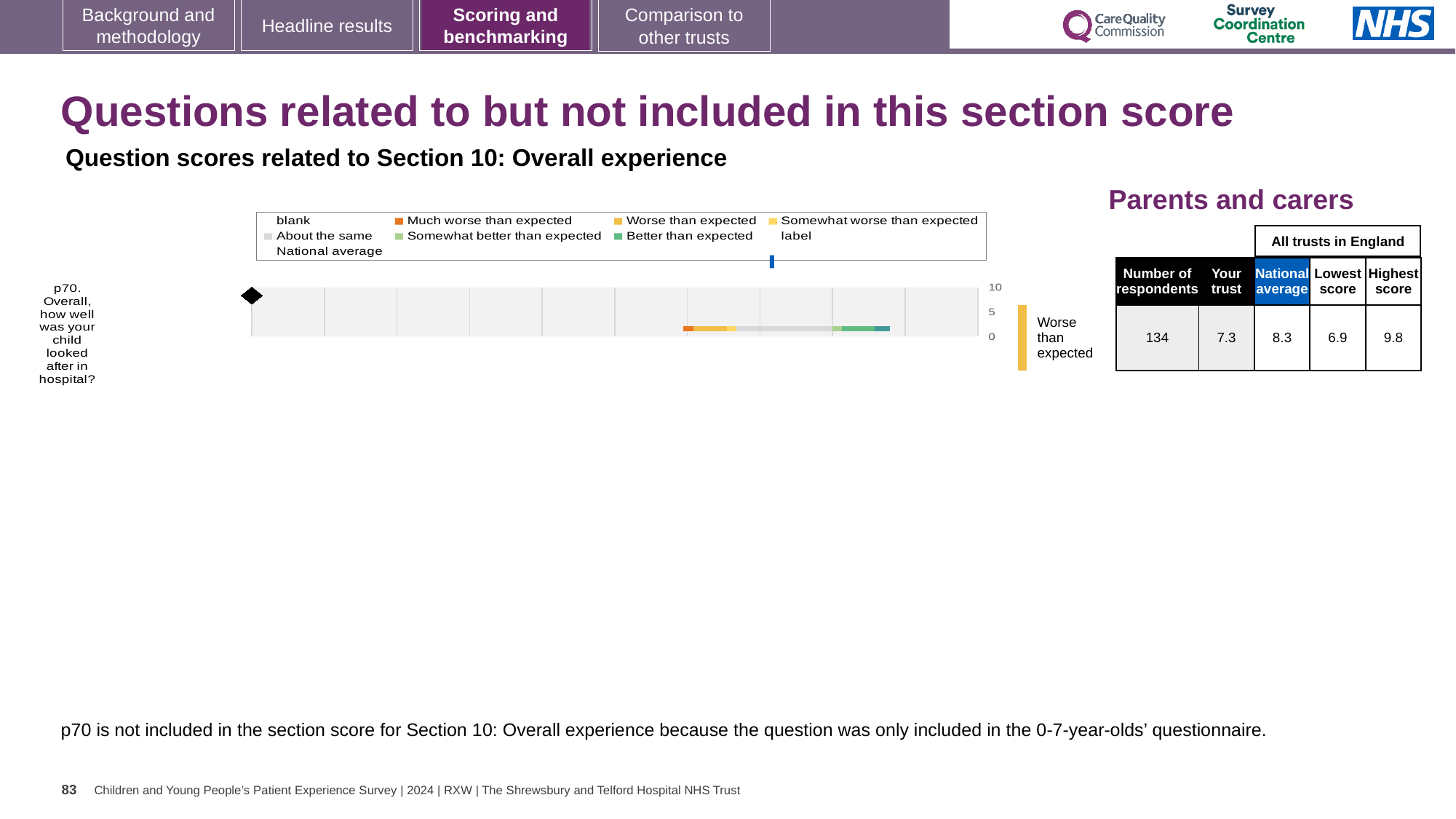
Which question is plotted on the chart? p70. Overall, how well was your child looked after in hospital? How many survey questions are plotted on the chart? 1 What is the lowest score among all trusts in England for p70? 6.9 What kind of chart is used to show the p70 question score? bar chart What is the national average score for p70? 8.3 What is the 'Your trust' score for p70? 7.3 Which is larger for p70, the 'Your trust' score or the national average? National average What is the highest score among all trusts in England for p70? 9.8 Is the 'Your trust' score for p70 greater or less than 5 on the chart's axis? greater What is the difference between the national average and the 'Your trust' score for p70? 1.0 What rating category is shown for the trust's score on p70? Worse than expected How many respondents answered p70? 134